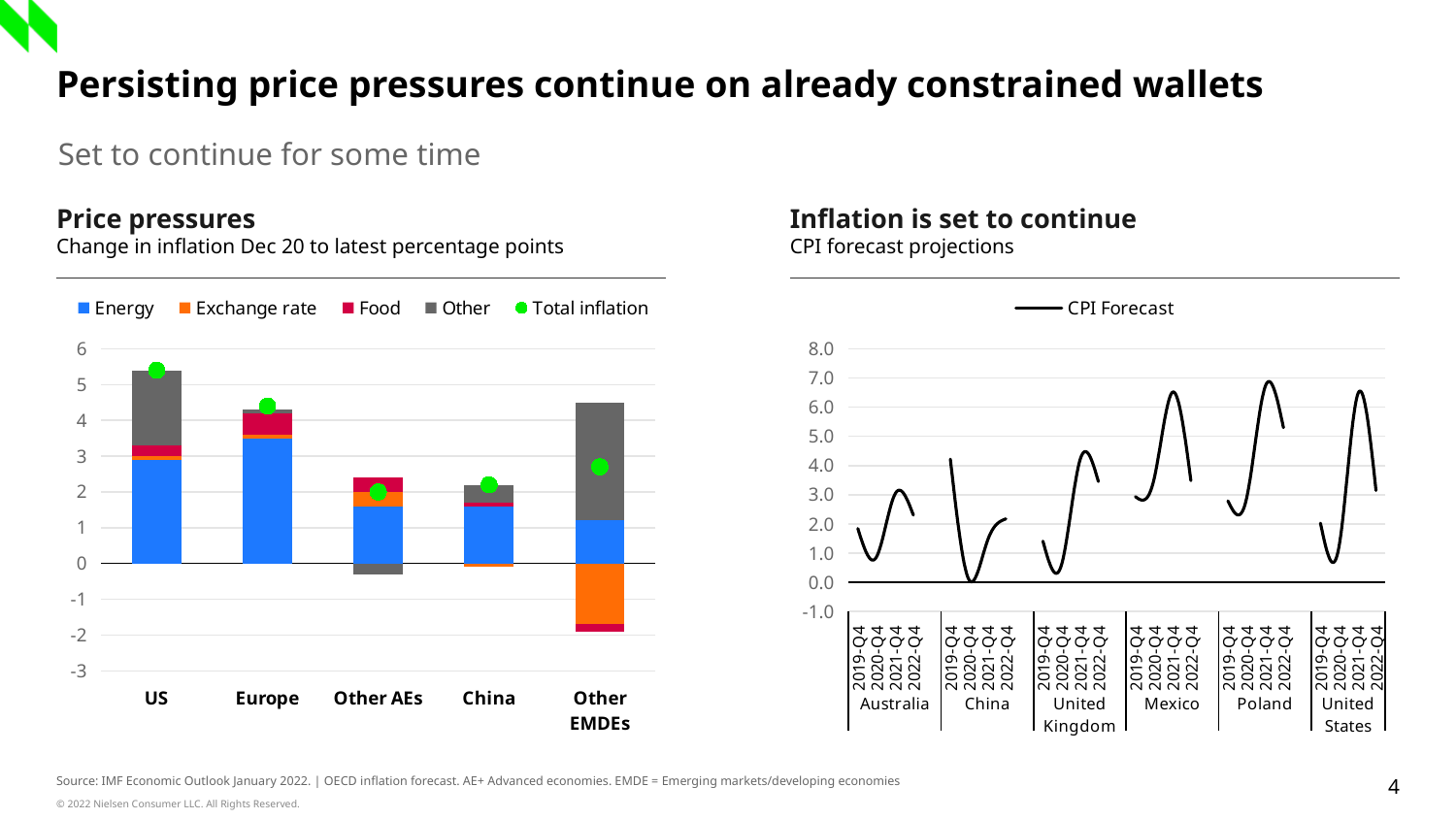
On the Price pressures chart, which region has a negative Exchange rate contribution that extends below -1? Other EMDEs On the Price pressures chart, which series is shown as green dots? Total inflation On the Inflation is set to continue chart, what kind of chart is used? line chart On the Price pressures chart, what kind of chart is used? bar chart On the Price pressures chart, is the Total inflation value for Other EMDEs greater or less than 3? less On the Price pressures chart, is the Total inflation value for the US greater or less than 5? greater On the Price pressures chart, how many entries does the legend list? 5 On the Inflation is set to continue chart, how many countries are shown on the x axis? 6 On the Inflation is set to continue chart, is the peak CPI forecast for Poland greater or less than 6.0? greater On the Price pressures chart, which region has the larger Energy contribution, Europe or the US? Europe On the Price pressures chart, how many regions are shown on the x axis? 5 On the Price pressures chart, which region has the highest Total inflation marker? US